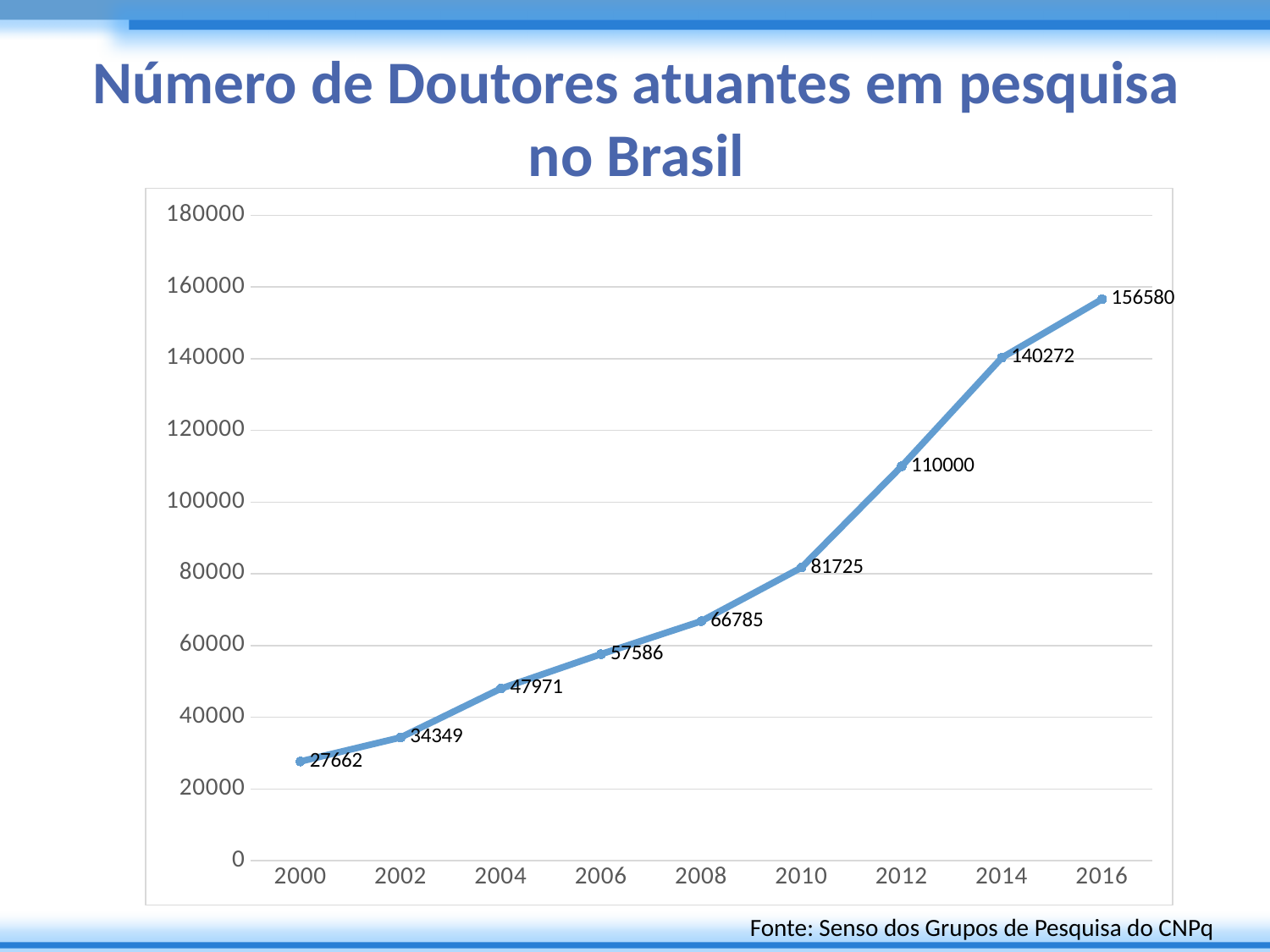
What kind of chart is shown on the slide? line chart Do the values rise or fall from 2000 to 2016? rise Which is larger, the value for 2006 or the value for 2008? 2008 Which year has the highest value? 2016 Which year has the lowest value? 2000 What is the value for 2016? 156580 How many data points are plotted on the chart? 9 What is the difference between the values for 2012 and 2010? 28275 What is the value for 2010? 81725 Is the value for 2012 greater or less than 100000? greater What is the value for 2000? 27662 What is the difference between the values for 2016 and 2014? 16308